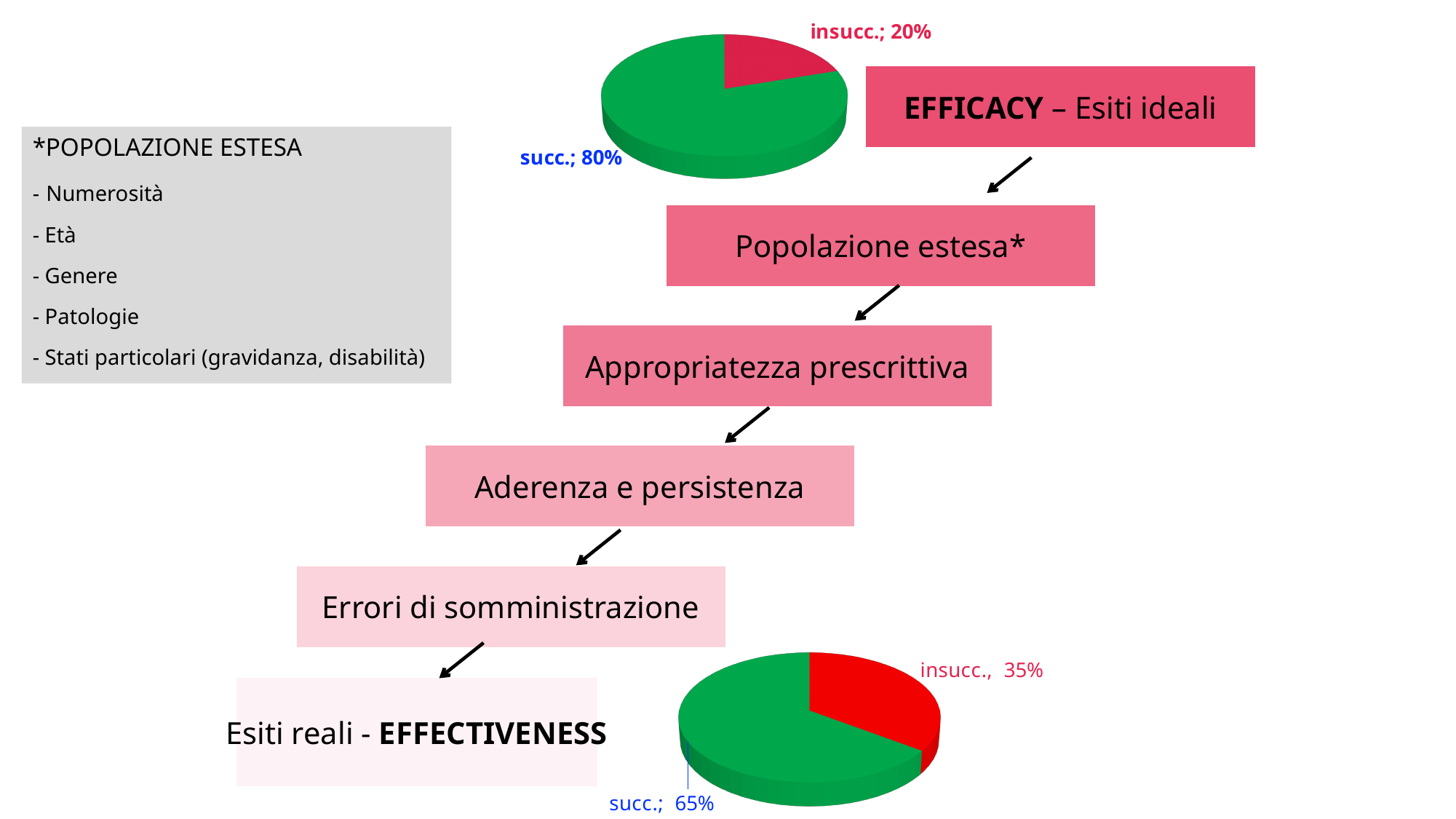
In the bottom pie chart, what is the value for insucc.? 35% In the bottom pie chart, which slice is the smallest? insucc. In the bottom pie chart, what is the value for succ.? 65% In the top pie chart, what is the difference between the succ. and insucc. values? 60% In the bottom pie chart, what colour is the insucc. slice? red What kind of chart is the top chart on the slide? pie chart In the top pie chart, what is the value for insucc.? 20% In the bottom pie chart, what is the difference between the succ. and insucc. values? 30% How many slices does the bottom pie chart have? 2 In the top pie chart, which slice is the largest? succ. Which is larger: the insucc. value in the top pie chart or the insucc. value in the bottom pie chart? bottom pie chart In the top pie chart, what is the value for succ.? 80%